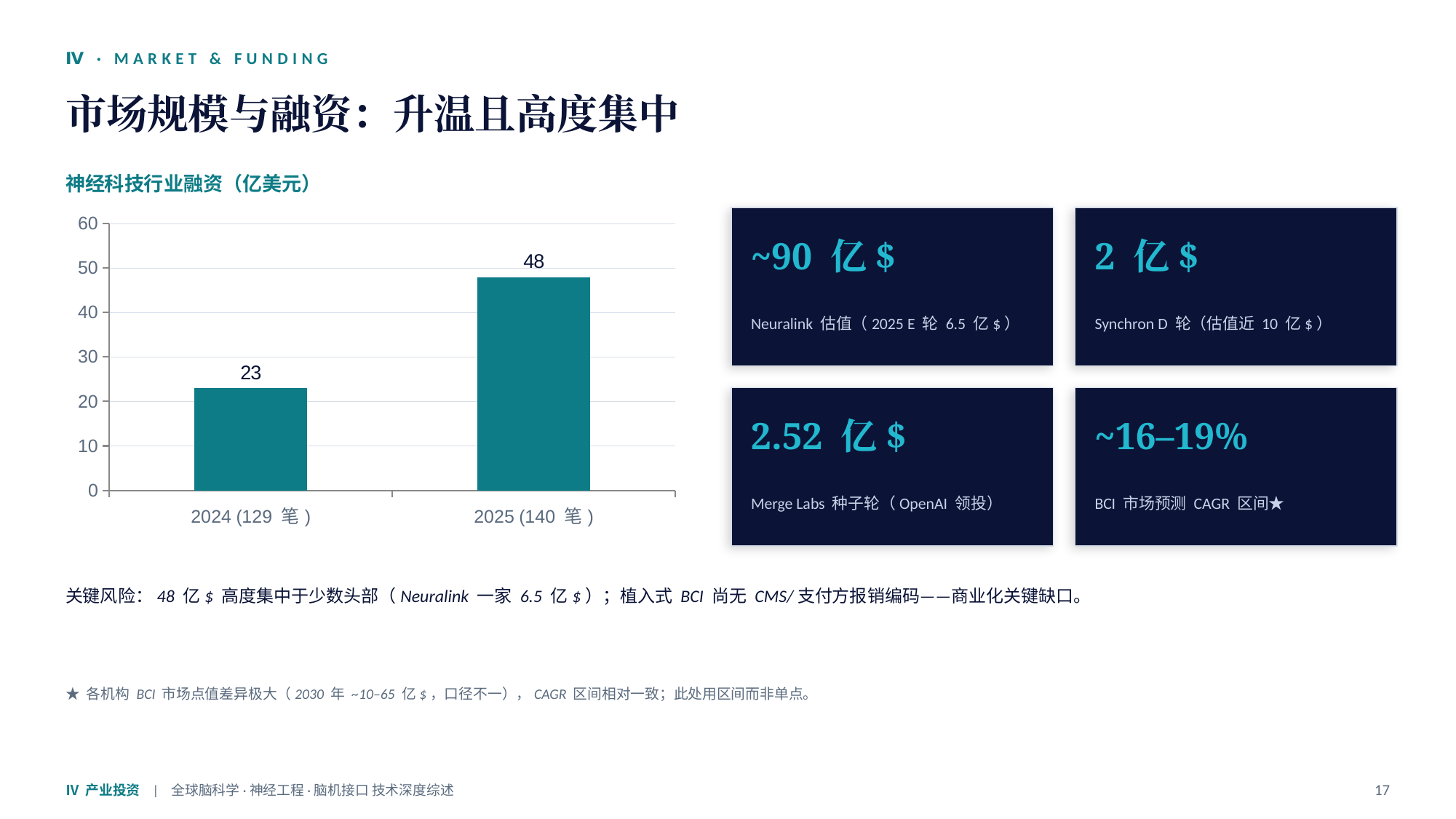
Is the value for 2024 or 2025 larger in the 神经科技行业融资 chart? 2025 What is the value for 2025 (140 笔) in the 神经科技行业融资 chart? 48 Is the value for 2025 (140 笔) greater or less than 40? greater What is the value for 2024 (129 笔) in the 神经科技行业融资 chart? 23 What is the difference between the 2025 and 2024 values in the 神经科技行业融资 chart? 25 How many categories are shown in the 神经科技行业融资 chart? 2 Do the values rise or fall from 2024 to 2025 in the 神经科技行业融资 chart? rise What kind of chart is the 神经科技行业融资 chart? bar chart What is the title of the chart on the slide? 神经科技行业融资（亿美元） Which category has the lowest value in the 神经科技行业融资 chart? 2024 (129 笔) Is the value for 2024 (129 笔) greater or less than 30? less Which category has the highest value in the 神经科技行业融资 chart? 2025 (140 笔)